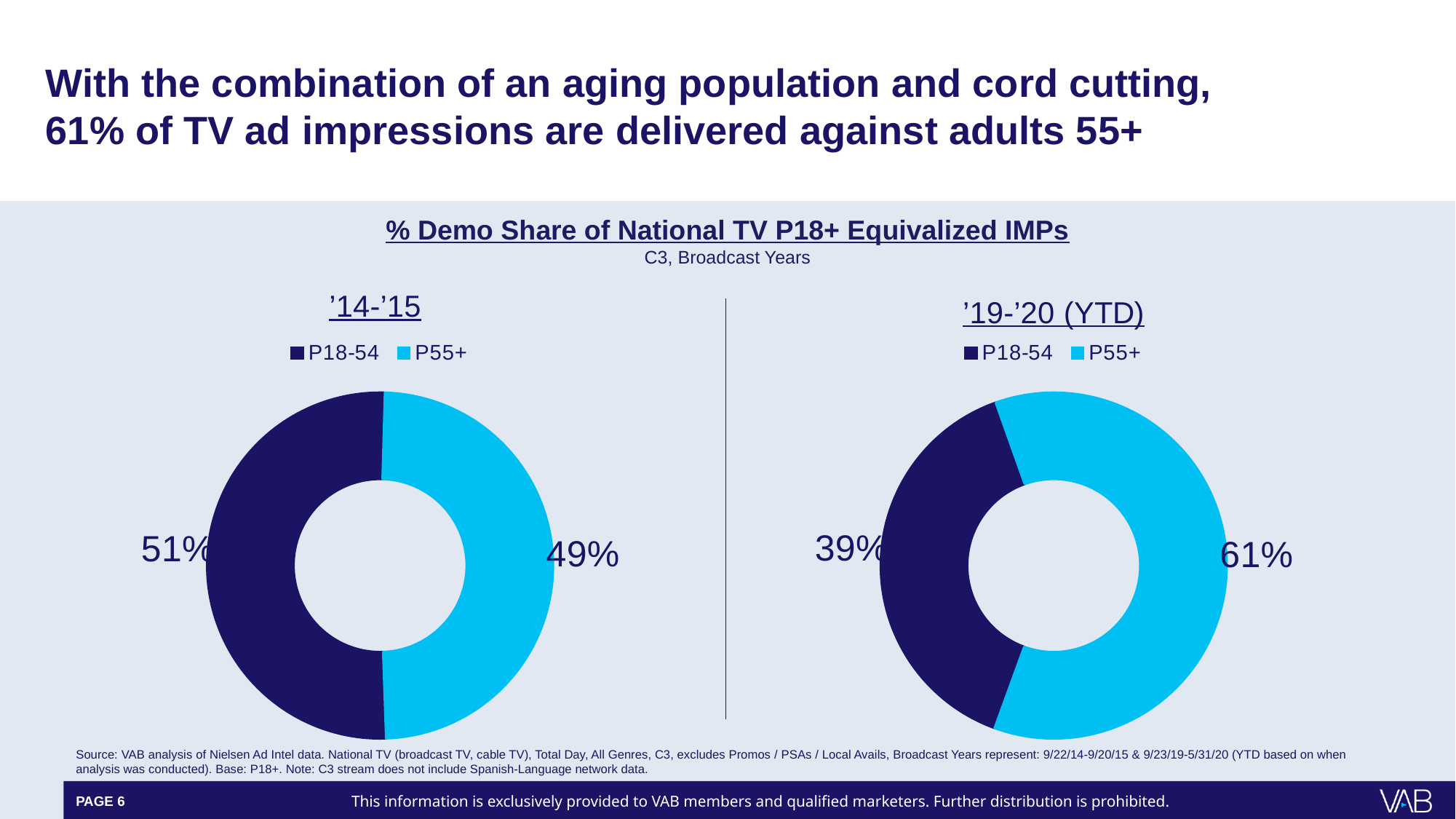
In the '19-'20 (YTD) chart, what share is shown for P55+? 61% In the '19-'20 (YTD) chart, what share is shown for P18-54? 39% In the '19-'20 (YTD) chart, which demo has the larger share? P55+ In the '19-'20 (YTD) chart, what is the difference between the P55+ share and the P18-54 share? 22% How many slices does the '19-'20 (YTD) chart have? 2 In the '14-'15 chart, what share is shown for P18-54? 51% Is the P55+ share larger in the '14-'15 chart or the '19-'20 (YTD) chart? '19-'20 (YTD) What type of chart is used on this slide? Doughnut chart In the '14-'15 chart, which demo has the smaller share? P55+ What is the overall title above the two charts? % Demo Share of National TV P18+ Equivalized IMPs How many series does the legend of the '14-'15 chart list? 2 In the '14-'15 chart, what share is shown for P55+? 49%